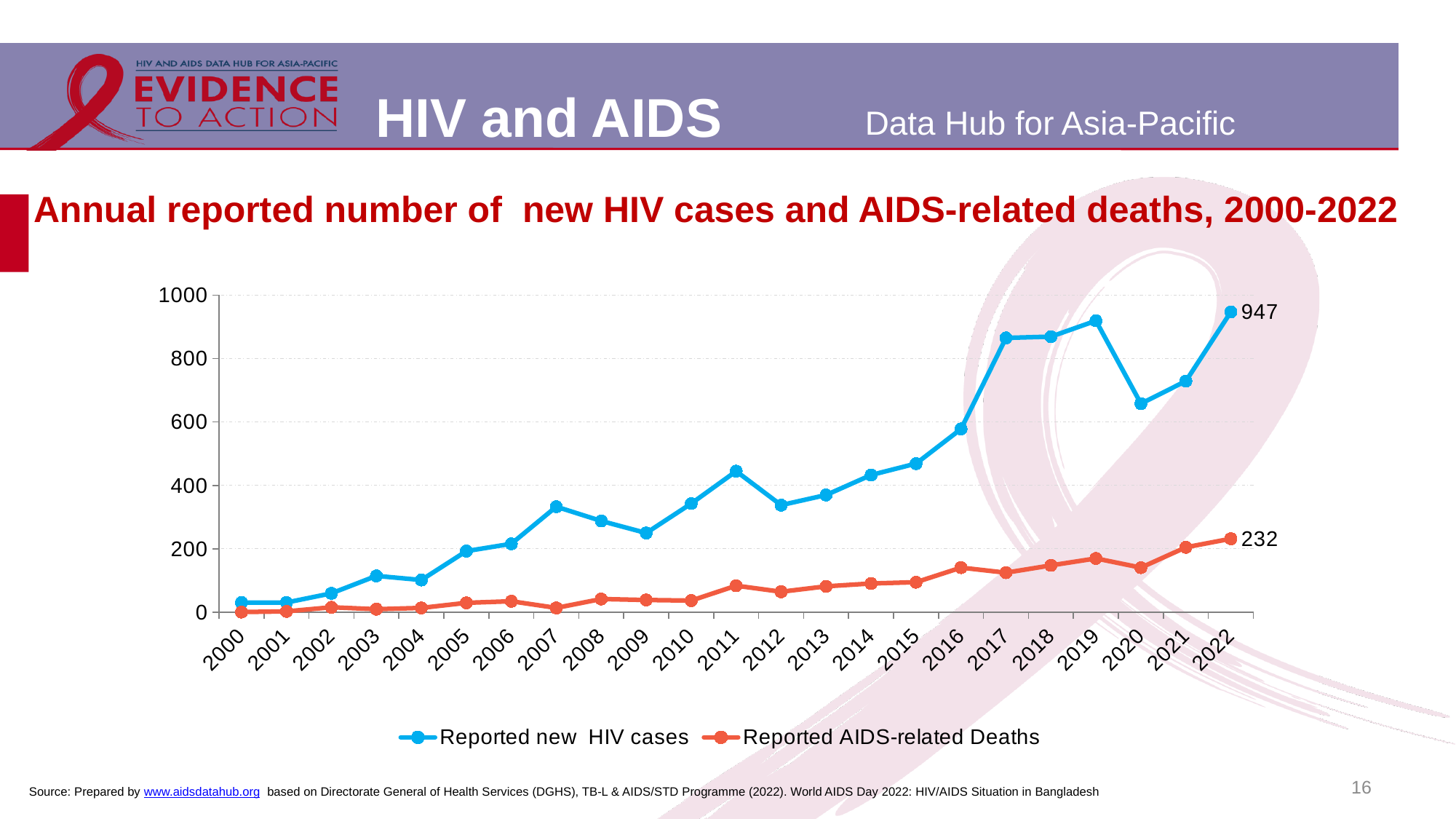
What is the difference between reported new HIV cases and reported AIDS-related deaths in 2022? 715 What kind of chart is shown on the slide? Line chart How many series does the legend list? 2 Which year has the highest reported number of AIDS-related deaths? 2022 Is the value for reported new HIV cases in 2020 greater or less than 800? less What is the reported number of new HIV cases in 2022? 947 Is the value for reported AIDS-related deaths in 2010 greater or less than 200? less Is the value for reported new HIV cases in 2019 greater or less than 800? greater What is the reported number of AIDS-related deaths in 2022? 232 How many years are plotted along the x axis? 23 In 2022, which is larger: reported new HIV cases or reported AIDS-related deaths? Reported new HIV cases Overall, do reported AIDS-related deaths rise or fall from 2000 to 2022? Rise